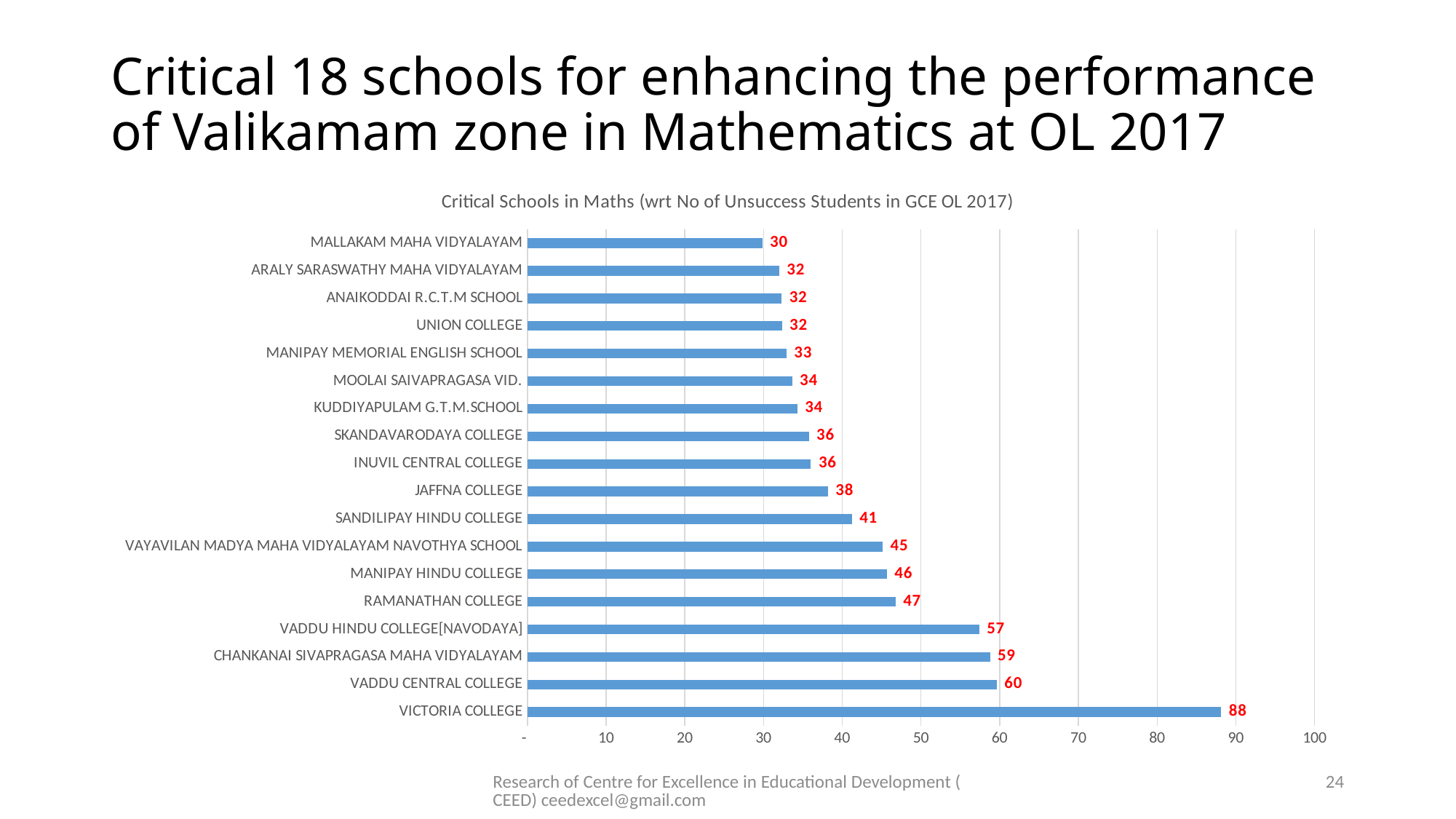
What is the value for Jaffna College? 38 What is the value for Victoria College? 88 What type of chart is shown on the slide? Bar chart Which is larger, the value for Manipay Hindu College or the value for Sandilipay Hindu College? Manipay Hindu College What is the title of the chart? Critical Schools in Maths (wrt No of Unsuccess Students in GCE OL 2017) Is the value for Chankanai Sivapragasa Maha Vidyalayam greater or less than 50? greater What is the value for Ramanathan College? 47 What is the value for Vaddu Hindu College[Navodaya]? 57 Which school has the lowest number of unsuccessful students? Mallakam Maha Vidyalayam What is the difference between the values for Victoria College and Vaddu Central College? 28 How many schools are shown in the chart? 18 Which school has the highest number of unsuccessful students? Victoria College